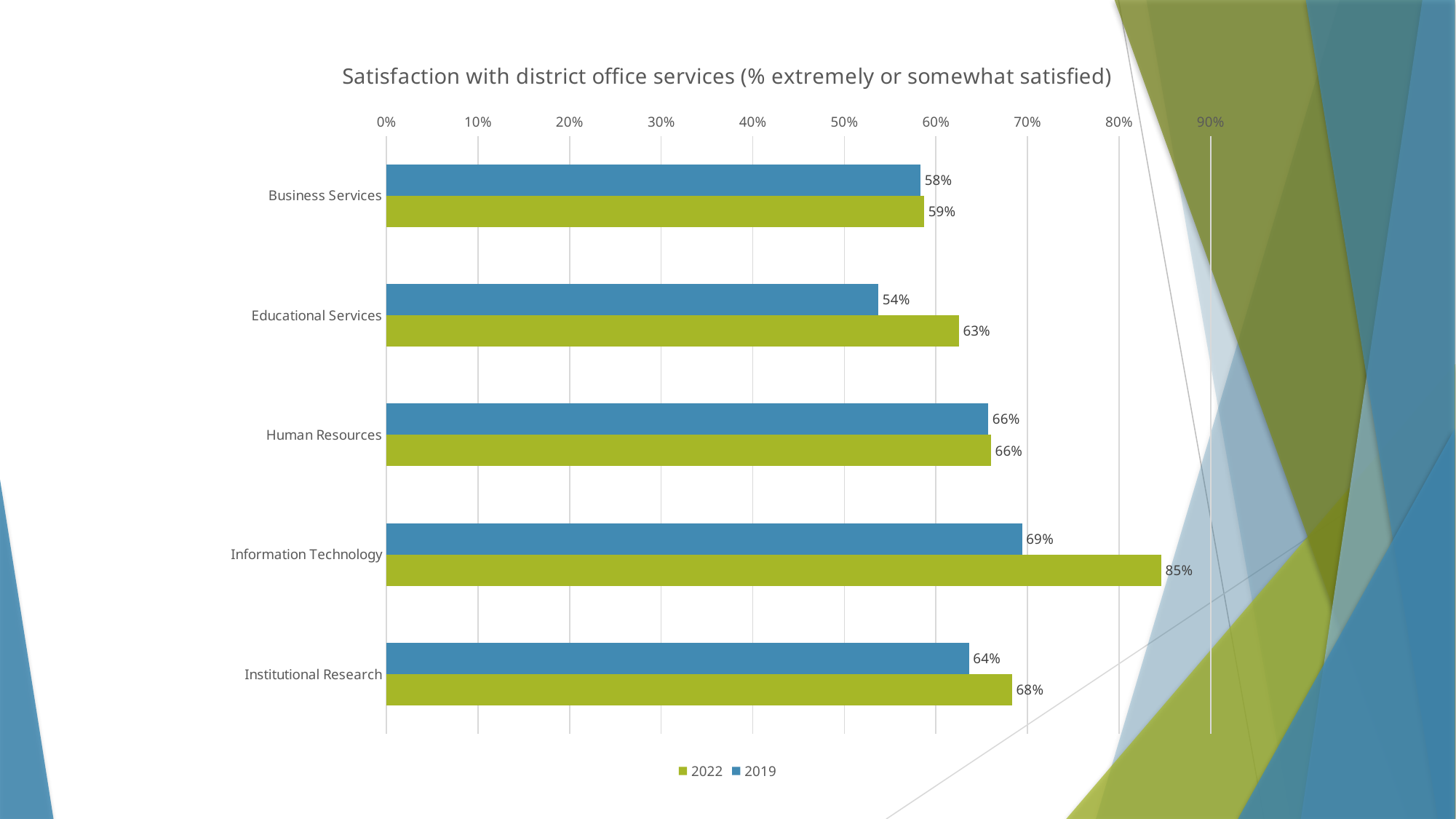
Is the 2022 value for Information Technology greater or less than 80%? greater What is the difference between the 2022 and 2019 values for Educational Services? 9% What is the difference between the 2022 and 2019 values for Information Technology? 16% What is the 2022 satisfaction value for Information Technology? 85% Which department has the highest 2022 satisfaction value? Information Technology How many series does the legend list? 2 Which department has the lowest 2019 satisfaction value? Educational Services How many departments are shown on the chart? 5 What kind of chart is shown on the slide? Bar chart What is the 2019 satisfaction value for Educational Services? 54% Which is larger for Institutional Research, the 2022 value or the 2019 value? 2022 What is the 2019 satisfaction value for Institutional Research? 64%